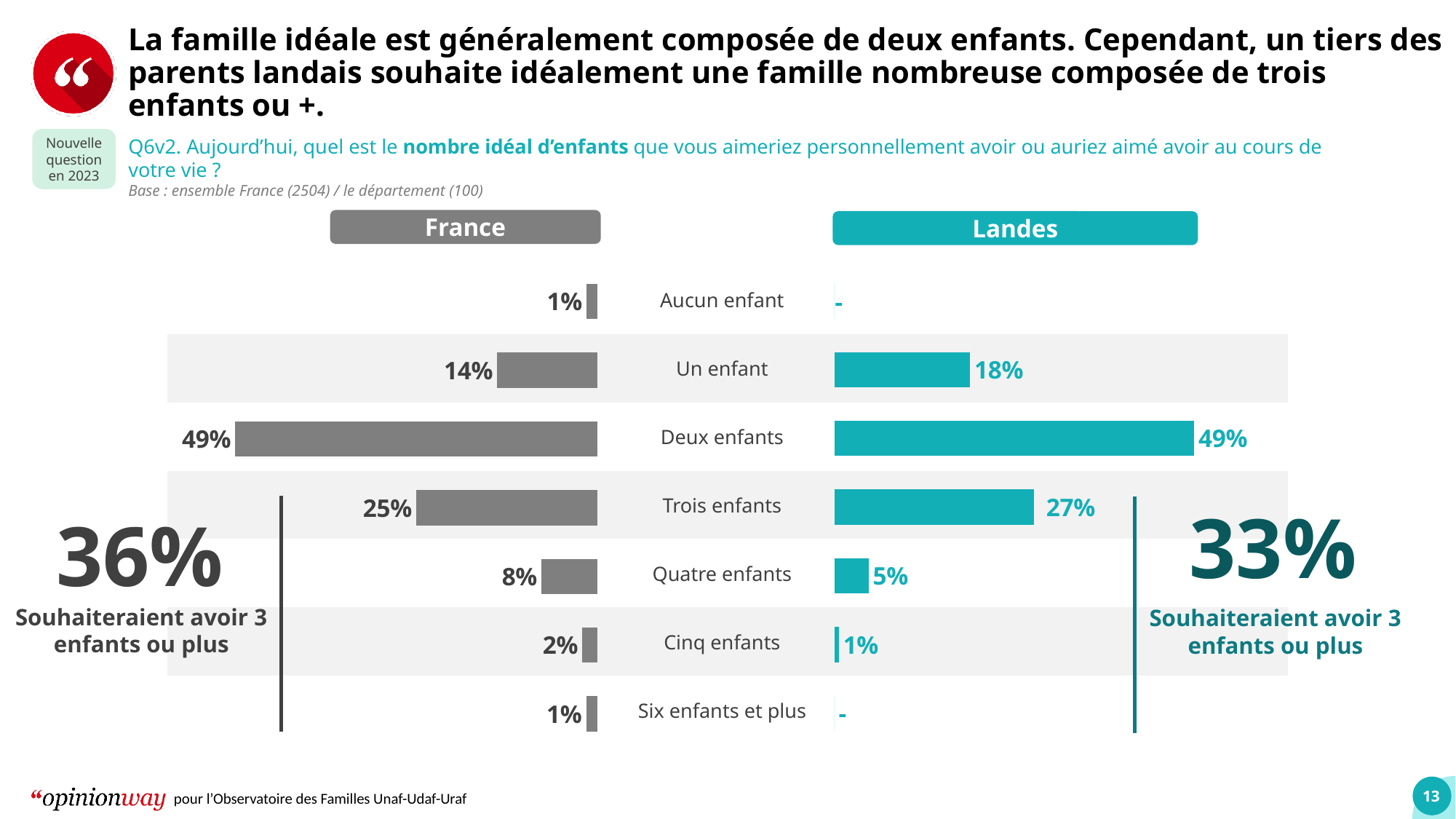
How many categories are shown in the France chart? 7 In the France chart, which category has the highest value? Deux enfants In the Landes chart, what is the difference between "Un enfant" and "Quatre enfants"? 13 percentage points Which is larger: the value for "Quatre enfants" in the France chart or in the Landes chart? France In the Landes chart, which category has the highest value? Deux enfants Which is larger: the value for "Un enfant" in the France chart or in the Landes chart? Landes In the Landes chart, what is the value for "Un enfant"? 18% In the France chart, what is the value for "Quatre enfants"? 8% In the France chart, what is the value for "Deux enfants"? 49% In the Landes chart, what is the value for "Trois enfants"? 27% In the France chart, what is the difference between "Deux enfants" and "Trois enfants"? 24 percentage points What type of chart is used to show the France and Landes results? Bar chart